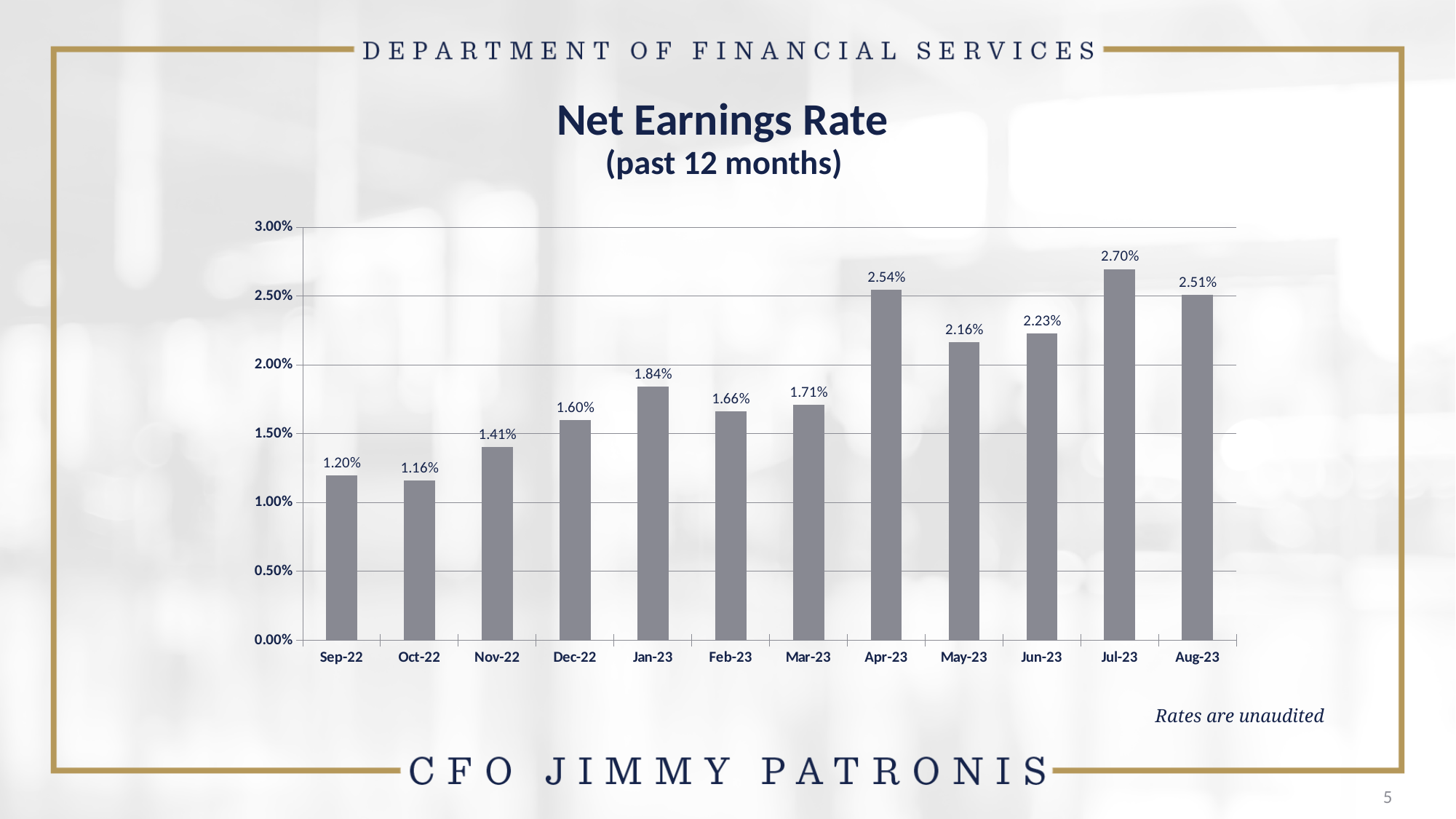
What is the title of the chart? Net Earnings Rate (past 12 months) What is the difference between the net earnings rate for Nov-22 and Dec-22? 0.19% How many months are shown on the chart? 12 Which is larger, the net earnings rate for May-23 or Jun-23? Jun-23 What is the net earnings rate for Jan-23? 1.84% Which month has the lowest net earnings rate? Oct-22 What is the net earnings rate for Apr-23? 2.54% What is the net earnings rate for Sep-22? 1.20% What is the difference between the net earnings rate for Jul-23 and Aug-23? 0.19% Is the net earnings rate for Mar-23 greater or less than 2.00%? less What kind of chart is shown on the slide? bar chart Which month has the highest net earnings rate? Jul-23